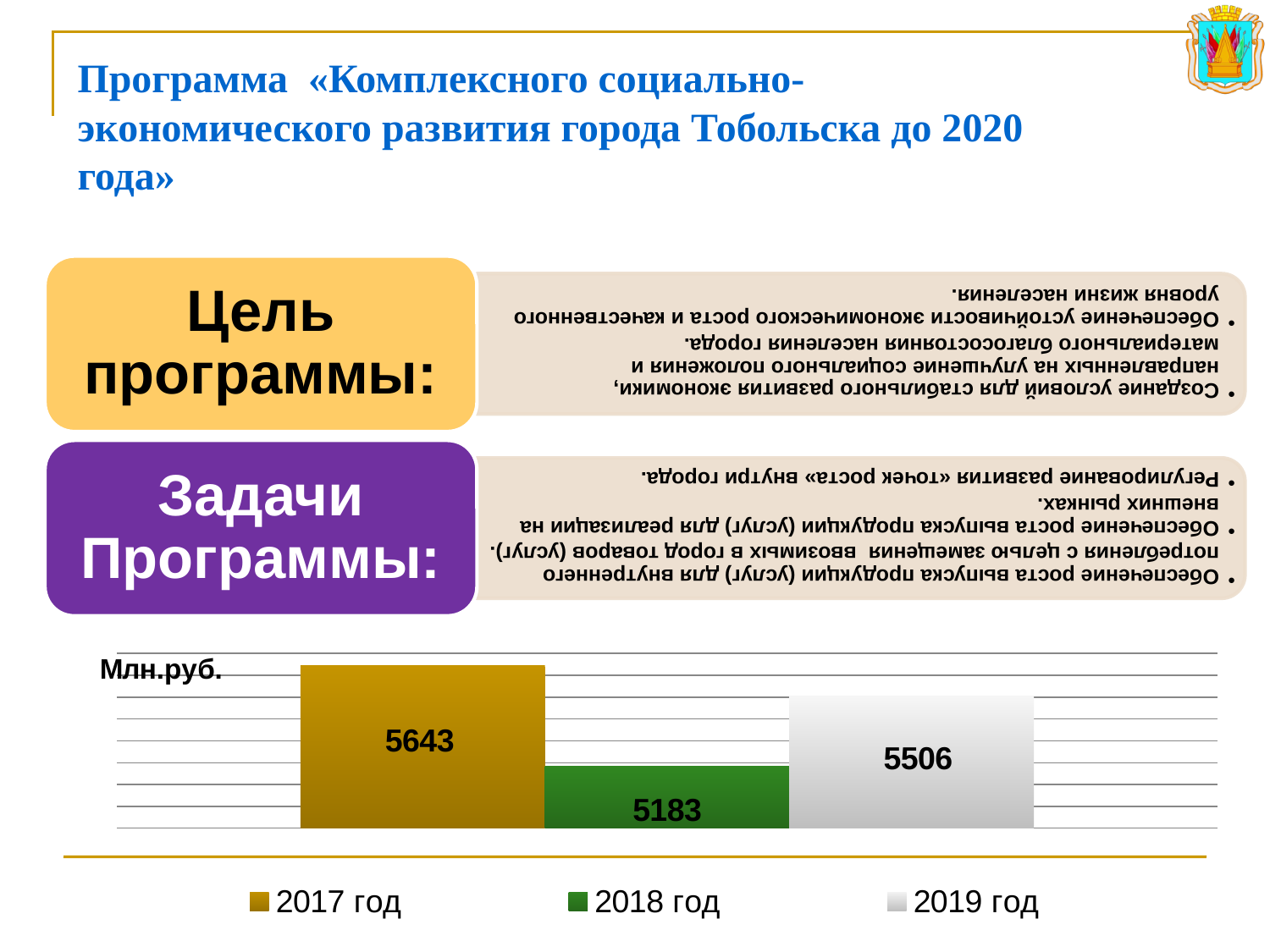
Which year has the highest value on the chart? 2017 год What unit is shown in the top-left corner of the chart? Млн.руб. What type of chart is shown on the slide? bar chart Which year has the lowest value on the chart? 2018 год What is the difference between the values for 2017 год and 2018 год? 460 Which is larger, the value for 2017 год or the value for 2019 год? 2017 год What is the value for 2017 год on the chart? 5643 What is the value for 2019 год on the chart? 5506 How many entries does the chart legend list? 3 How many bars are plotted on the chart? 3 What is the value for 2018 год on the chart? 5183 What is the difference between the values for 2019 год and 2018 год? 323